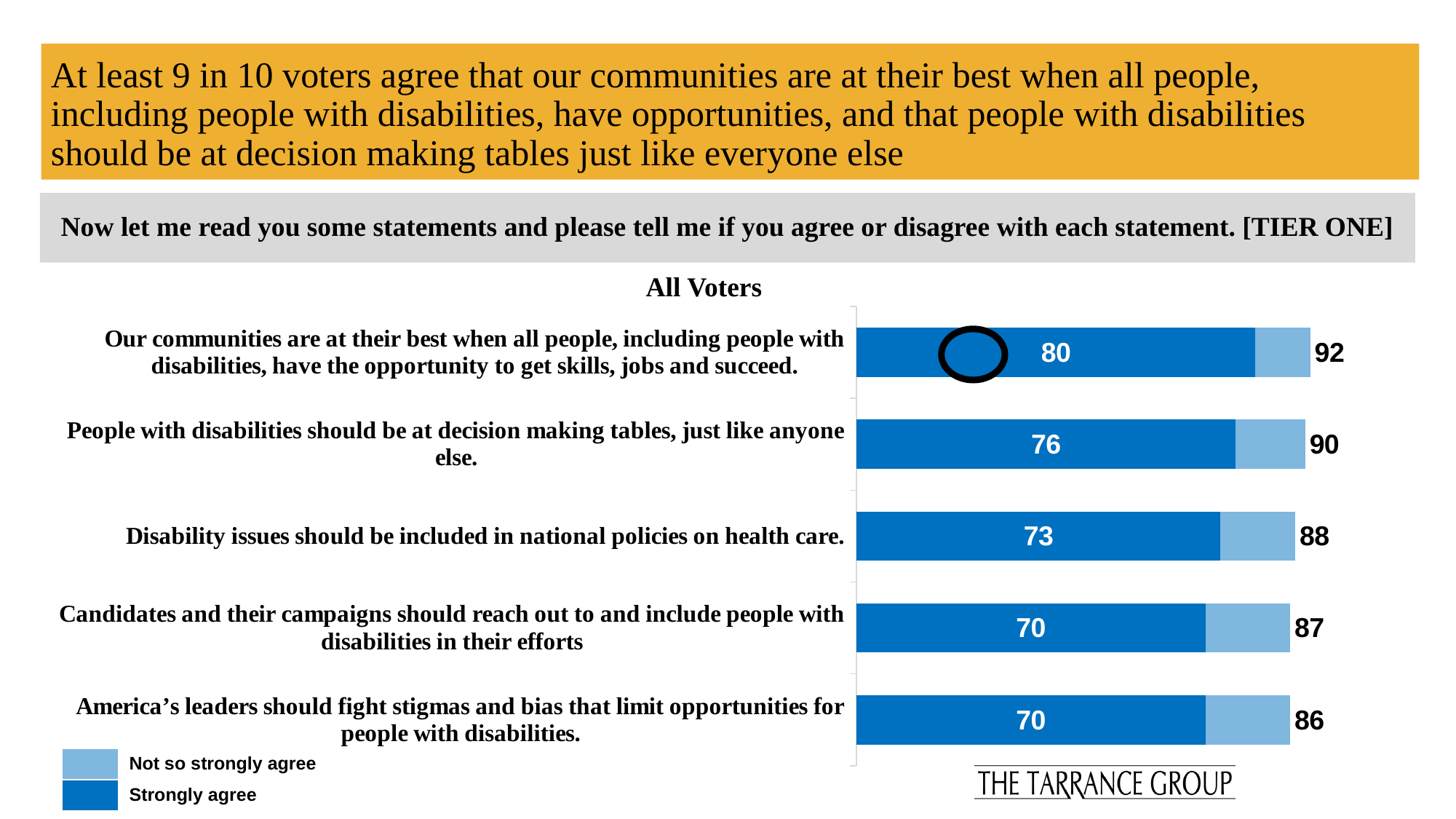
What is the total agreement shown for the statement 'People with disabilities should be at decision making tables, just like anyone else.'? 90 Which statement has the lowest total agreement? America's leaders should fight stigmas and bias that limit opportunities for people with disabilities. What kind of chart is shown on the slide? Stacked bar chart Which statement has the highest 'Strongly agree' value? Our communities are at their best when all people, including people with disabilities, have the opportunity to get skills, jobs and succeed. Which is larger: the 'Strongly agree' value for 'People with disabilities should be at decision making tables' or for 'Disability issues should be included in national policies on health care'? People with disabilities should be at decision making tables, just like anyone else. What is the 'Strongly agree' value for 'Disability issues should be included in national policies on health care.'? 73 What is the title shown above the chart? All Voters What is the total agreement shown for 'America's leaders should fight stigmas and bias that limit opportunities for people with disabilities.'? 86 What is the 'Strongly agree' value for the statement 'Our communities are at their best when all people, including people with disabilities, have the opportunity to get skills, jobs and succeed.'? 80 How many series does the legend list? 2 How many statements are plotted in the chart? 5 What is the difference between the total agreement (92) and the 'Strongly agree' value (80) for the statement about communities being at their best? 12